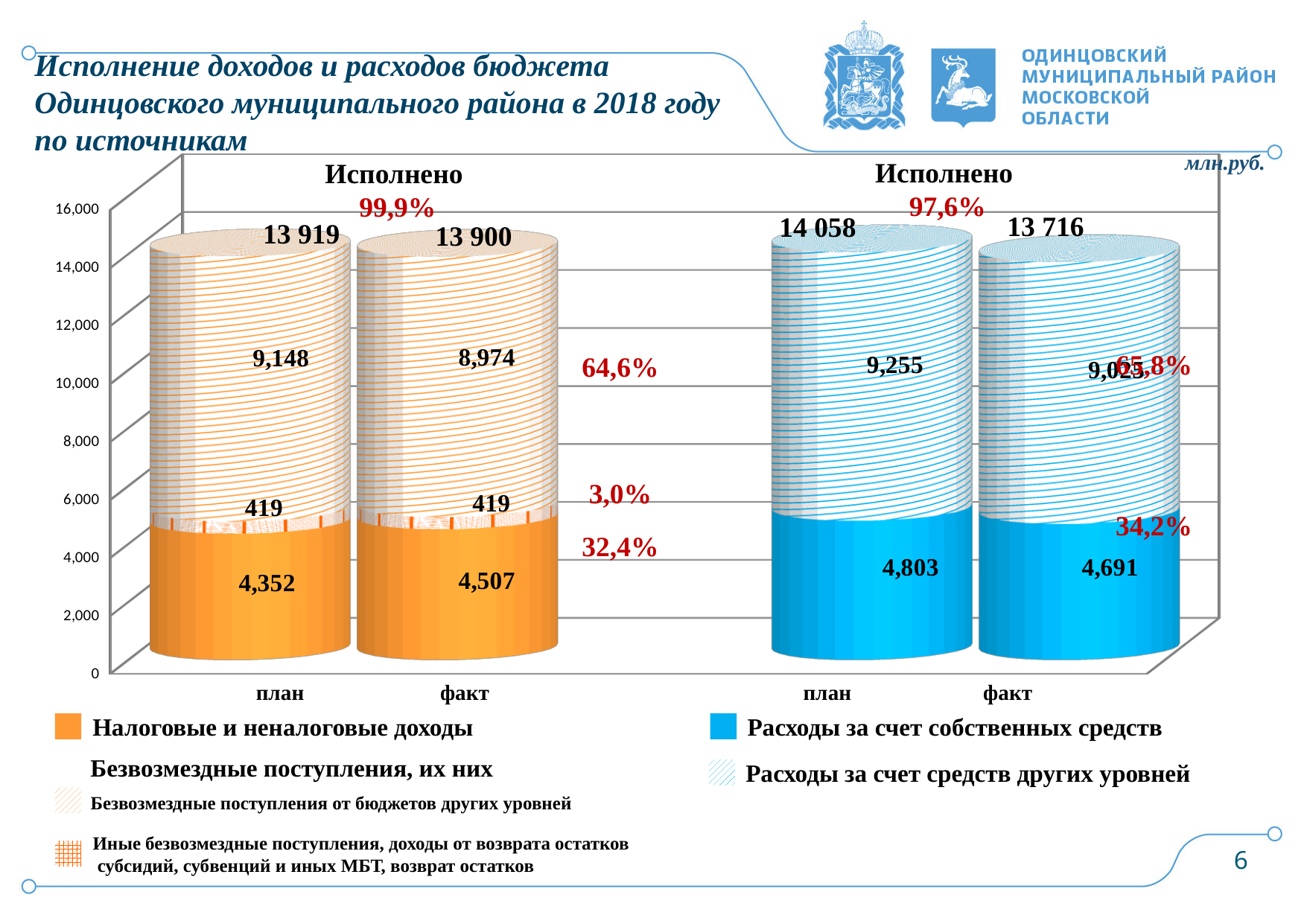
What is the difference between факт and план for Налоговые и неналоговые доходы? 155 What is the total of the факт bar for расходы (the right group)? 13 716 What execution percentage (Исполнено) is shown above the доходы bars on the left? 99,9% What is the value of Налоговые и неналоговые доходы for план? 4,352 What is the value of Расходы за счет средств других уровней for план? 9,255 Which is larger for Налоговые и неналоговые доходы: план or факт? факт What is the value of Безвозмездные поступления от бюджетов других уровней for факт? 8,974 What is the value of Налоговые и неналоговые доходы for факт? 4,507 What is the value of Расходы за счет собственных средств for план? 4,803 What is the value of Расходы за счет собственных средств for факт? 4,691 What is the total of the план bar for доходы (the left group)? 13 919 What kind of chart is shown on the slide? bar chart